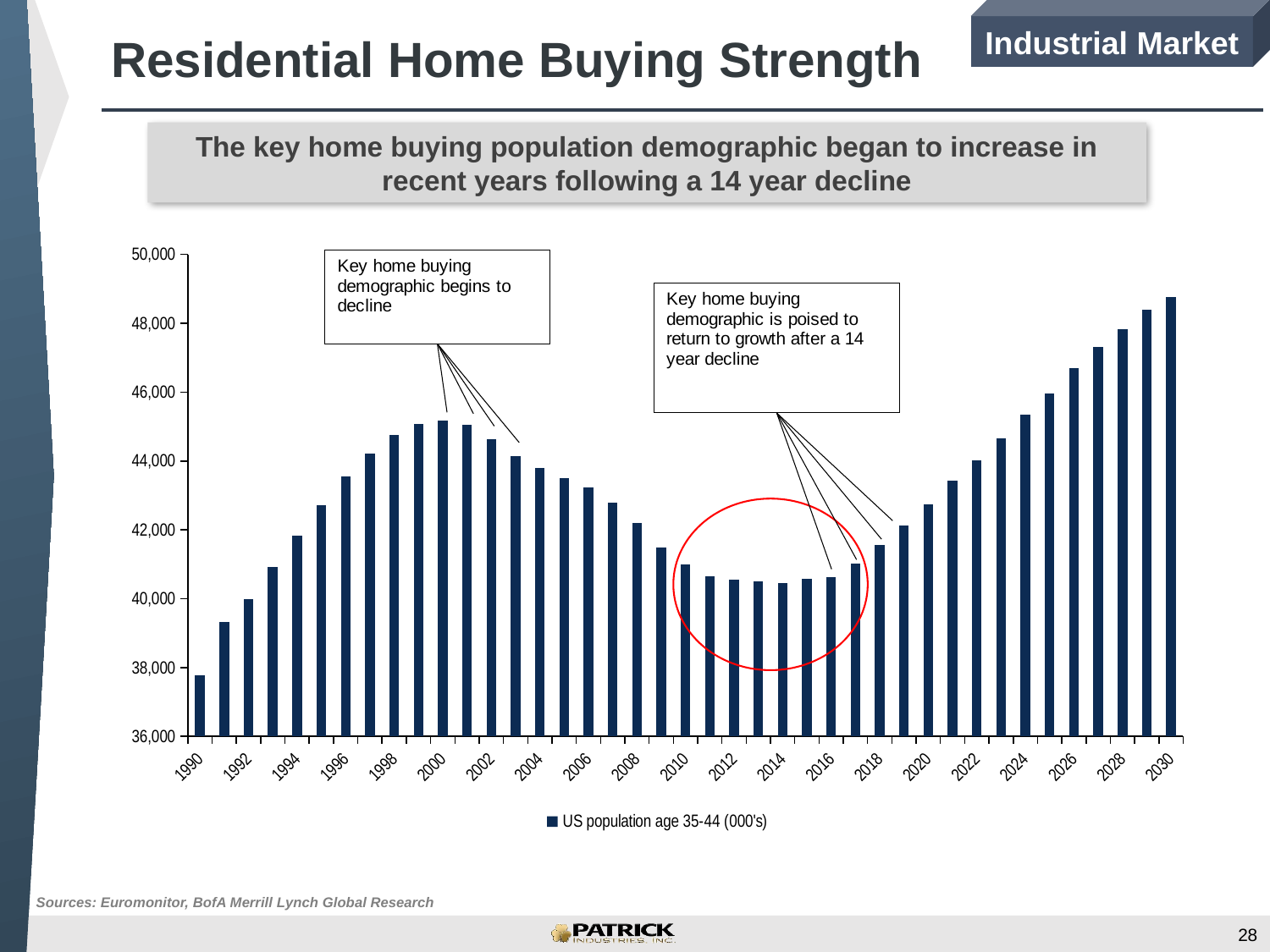
What kind of chart is shown on the slide? bar chart Do the values rise or fall from 2000 to 2014? fall Which year has the highest value? 2030 Is the value for 2030 greater or less than 48,000? greater How many years (bars) are plotted on the chart? 41 Which year has the lowest value? 1990 Is the value for 2014 greater or less than 40,000? greater How many series does the legend list? 1 Is the value for 1990 greater or less than 38,000? less Which year has the larger value, 2000 or 2014? 2000 What is the name of the series shown in the legend? US population age 35-44 (000's)